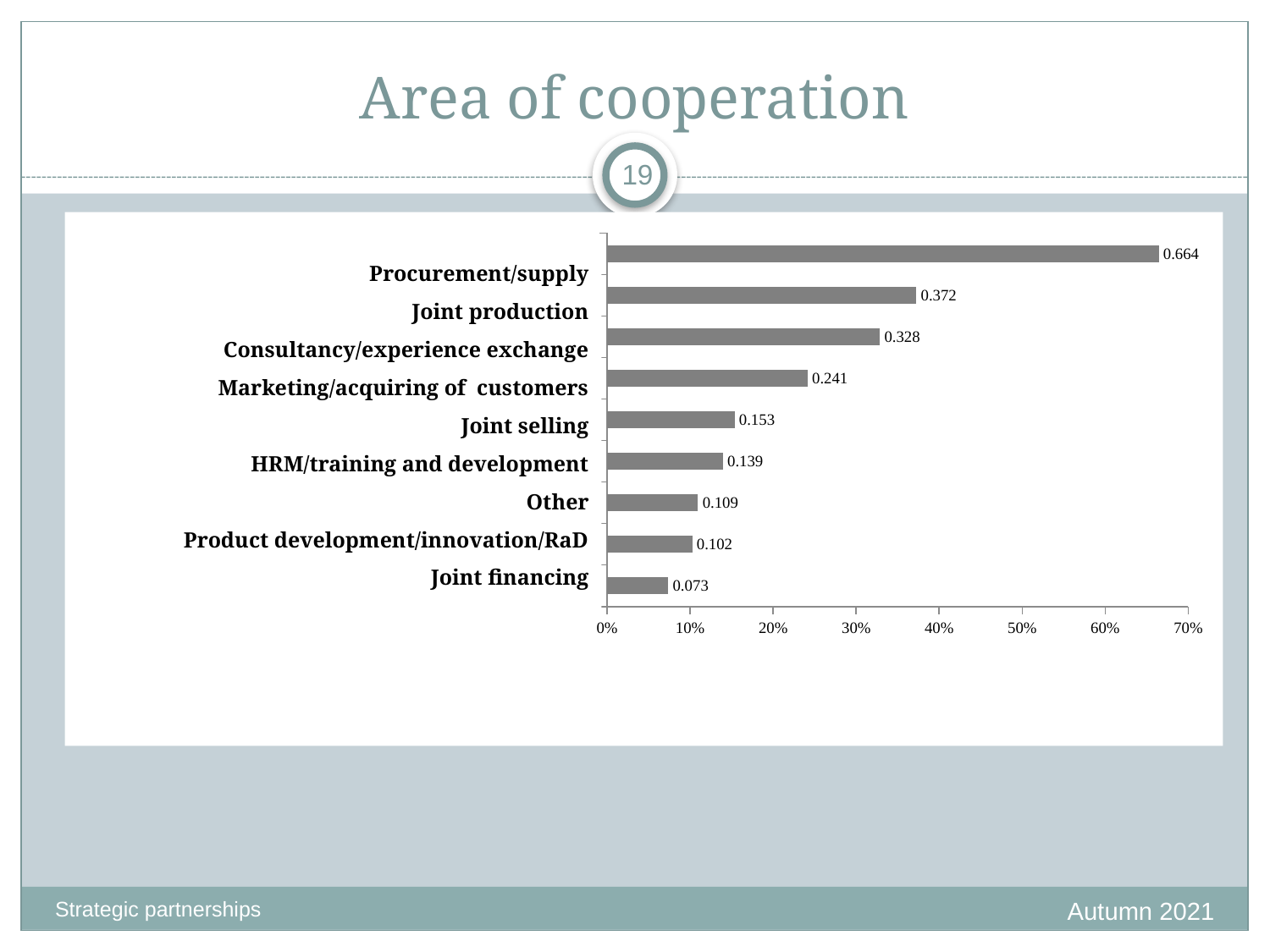
What is the value for Marketing/acquiring of customers? 0.241 Which is larger, the value for Consultancy/experience exchange or the value for Joint selling? Consultancy/experience exchange What is the title of the slide containing the chart? Area of cooperation How many categories are shown in the chart? 9 Is the value for HRM/training and development greater or less than 20%? less Which area of cooperation has the highest value? Procurement/supply What kind of chart is shown on the slide? bar chart What is the value for Joint production? 0.372 What is the value for Procurement/supply? 0.664 What is the difference between the values for Procurement/supply and Joint production? 0.292 What is the value for Joint financing? 0.073 Which area of cooperation has the lowest value? Joint financing